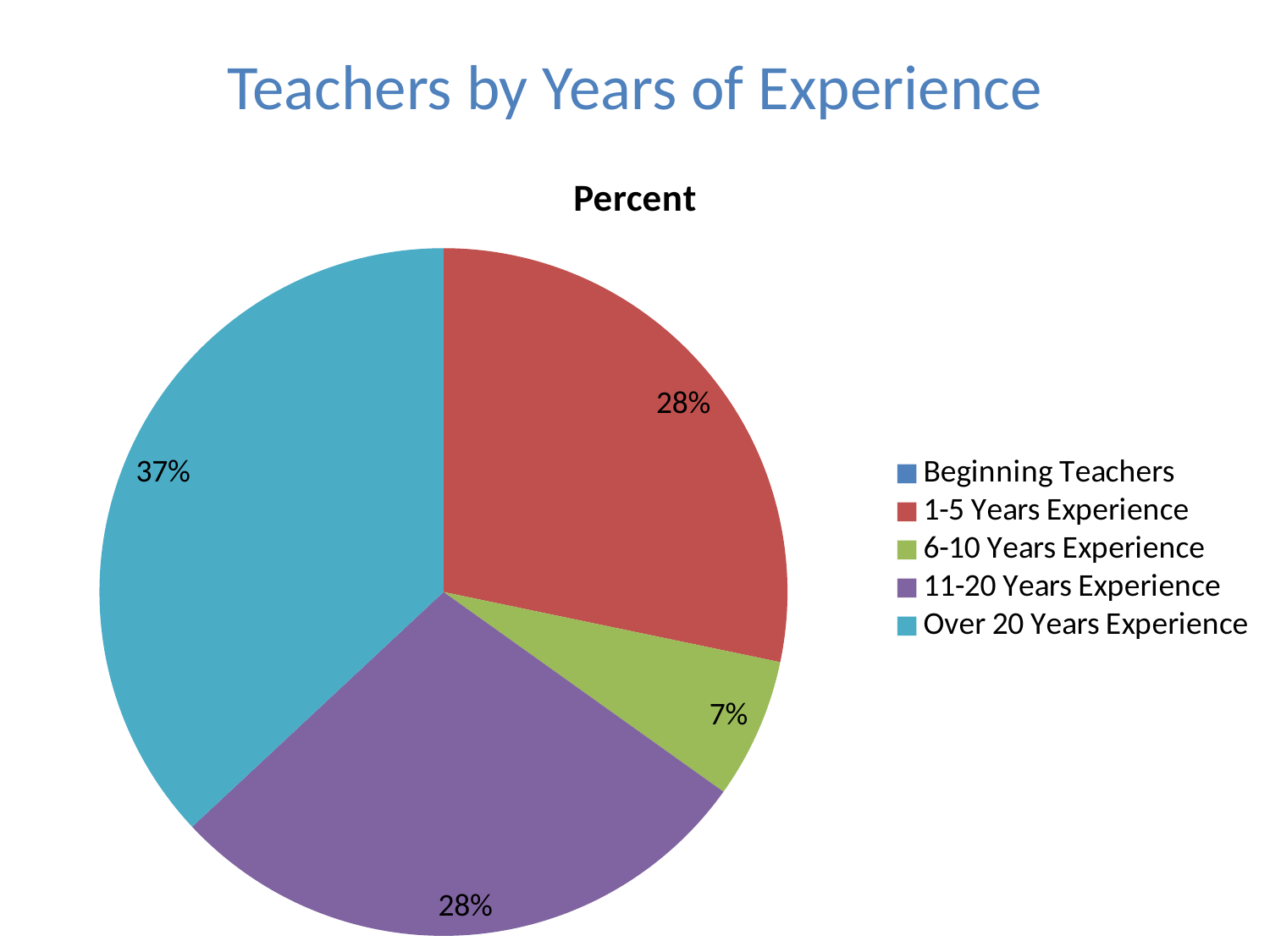
Which is larger: the share for Over 20 Years Experience or the share for 11-20 Years Experience? Over 20 Years Experience Which category has the largest share of the pie? Over 20 Years Experience How many percentage points larger is the 11-20 Years Experience share than the 6-10 Years Experience share? 21 percentage points What kind of chart is shown on the slide? Pie chart How many percentage points larger is the Over 20 Years Experience share than the 1-5 Years Experience share? 9 percentage points What percentage of teachers have 6-10 Years Experience? 7% How many categories does the legend list? 5 What percentage of teachers have Over 20 Years Experience? 37% Which category is labeled with the smallest visible share, 7%? 6-10 Years Experience What percentage of teachers have 1-5 Years Experience? 28% What is the title of the slide? Teachers by Years of Experience What percentage of teachers have 11-20 Years Experience? 28%